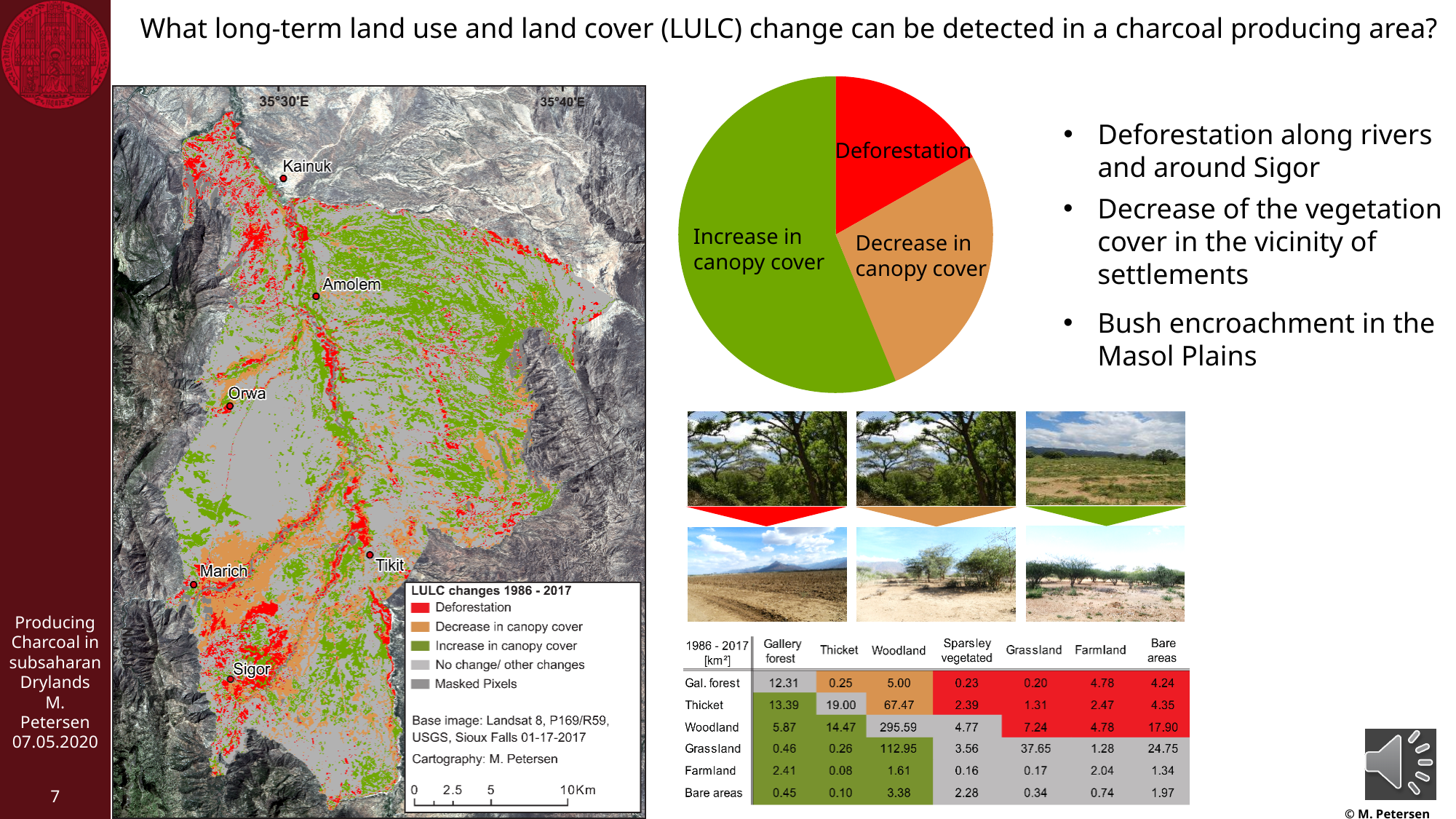
What colour is the Deforestation slice in the pie chart? red In the pie chart, which slice is larger: Deforestation or Decrease in canopy cover? Decrease in canopy cover Which category takes up the smallest slice of the pie chart? Deforestation What colour is the Increase in canopy cover slice in the pie chart? green In the pie chart, which slice is larger: Increase in canopy cover or Decrease in canopy cover? Increase in canopy cover Which category takes up the largest slice of the pie chart? Increase in canopy cover How many slices does the pie chart have? 3 Is the share of the pie chart for Increase in canopy cover greater or less than 50%? greater What kind of chart is shown on the slide? pie chart